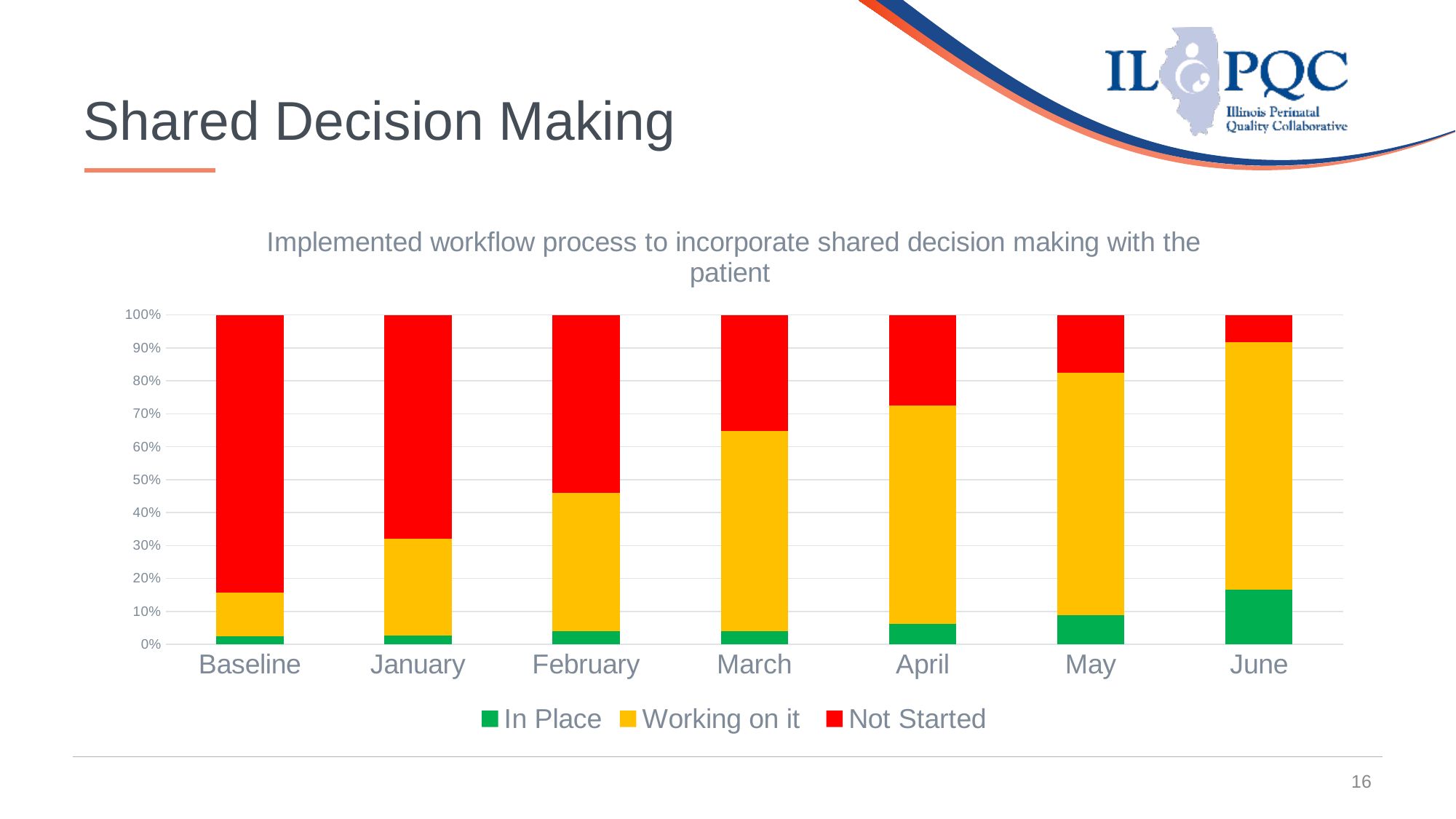
Is the 'In Place' share for June greater or less than 10%? greater Is the 'Not Started' share for Baseline greater or less than 50%? greater Which category has the smallest 'Not Started' segment? June Is the 'Not Started' share for June greater or less than 20%? less Does the 'Not Started' share rise or fall from Baseline to June? fall Which category has the largest 'Not Started' segment? Baseline What kind of chart is shown on the slide? Stacked bar chart How many series does the chart's legend list? 3 How many categories are shown along the x axis of the chart? 7 Which colour represents the 'Not Started' series in the chart? Red Which category has the largest 'In Place' segment? June What is the title of the chart? Implemented workflow process to incorporate shared decision making with the patient